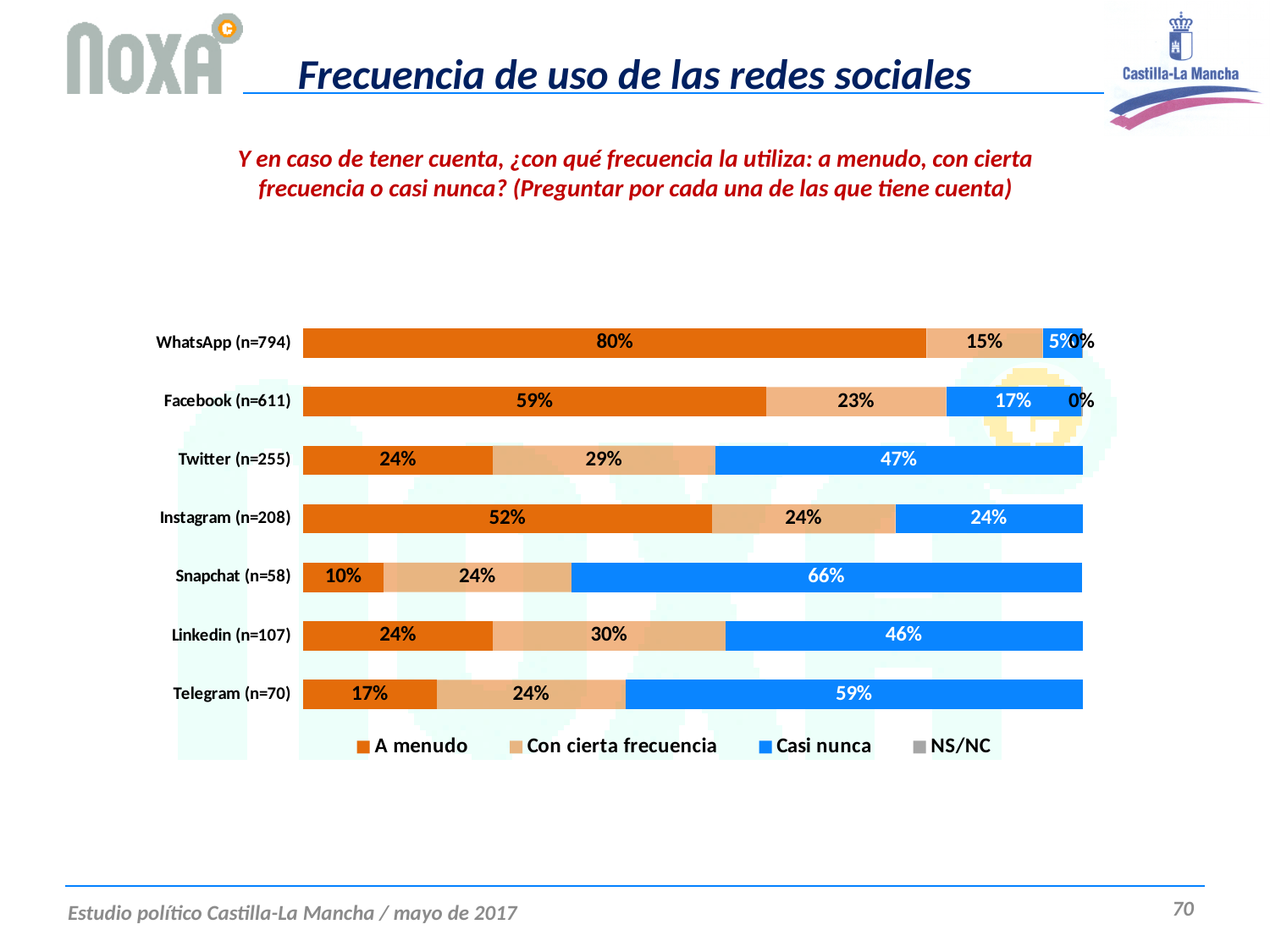
How many series does the legend list? 4 What is the 'Casi nunca' value for Snapchat (n=58)? 66% What is the 'Casi nunca' value for Facebook (n=611)? 17% How many social networks (categories) are shown in the chart? 7 What kind of chart is shown on the slide? Stacked bar chart Which legend entry is shown in blue? Casi nunca Which is larger: the 'Casi nunca' value for Twitter (n=255) or for Telegram (n=70)? Telegram (n=70) What is the difference between the 'A menudo' values for WhatsApp (n=794) and Facebook (n=611)? 21% Which social network has the lowest 'A menudo' value? Snapchat (n=58) What is the 'A menudo' value for WhatsApp (n=794)? 80% Which social network has the highest 'A menudo' value? WhatsApp (n=794) What is the 'Con cierta frecuencia' value for Linkedin (n=107)? 30%